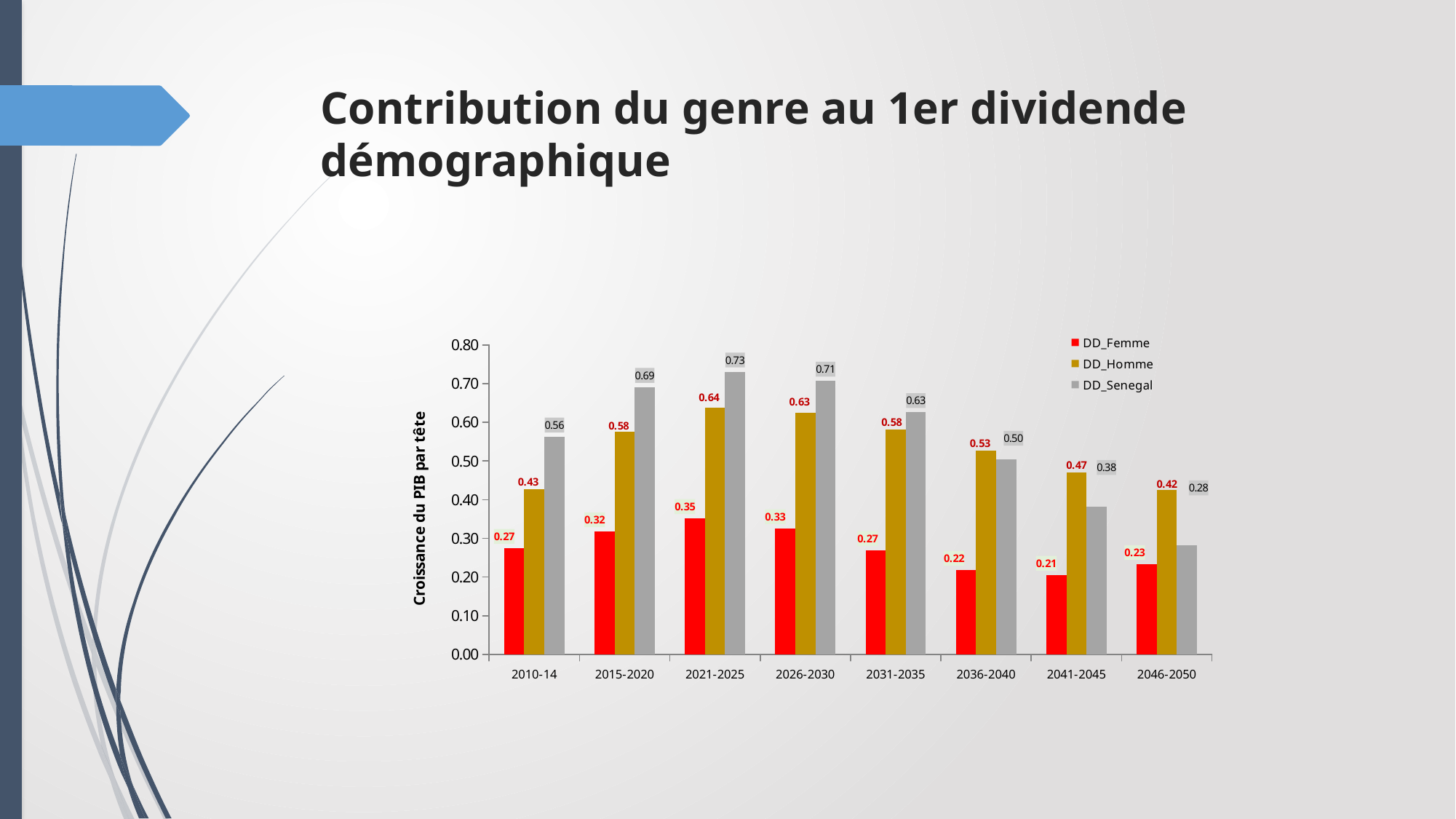
In which period is DD_Senegal lowest? 2046-2050 What kind of chart is shown on the slide? Bar chart Does DD_Senegal rise or fall from 2021-2025 to 2046-2050? Fall In which period is DD_Femme highest? 2021-2025 What is the value of DD_Senegal for 2015-2020? 0.69 What is the difference between DD_Homme and DD_Femme in 2010-14? 0.16 How many periods are shown on the x axis? 8 What is the value of DD_Homme for 2021-2025? 0.64 What is the title of the vertical axis? Croissance du PIB par tête What is the value of DD_Femme for 2041-2045? 0.21 In 2036-2040, which is larger: DD_Homme or DD_Senegal? DD_Homme How many series does the legend list? 3